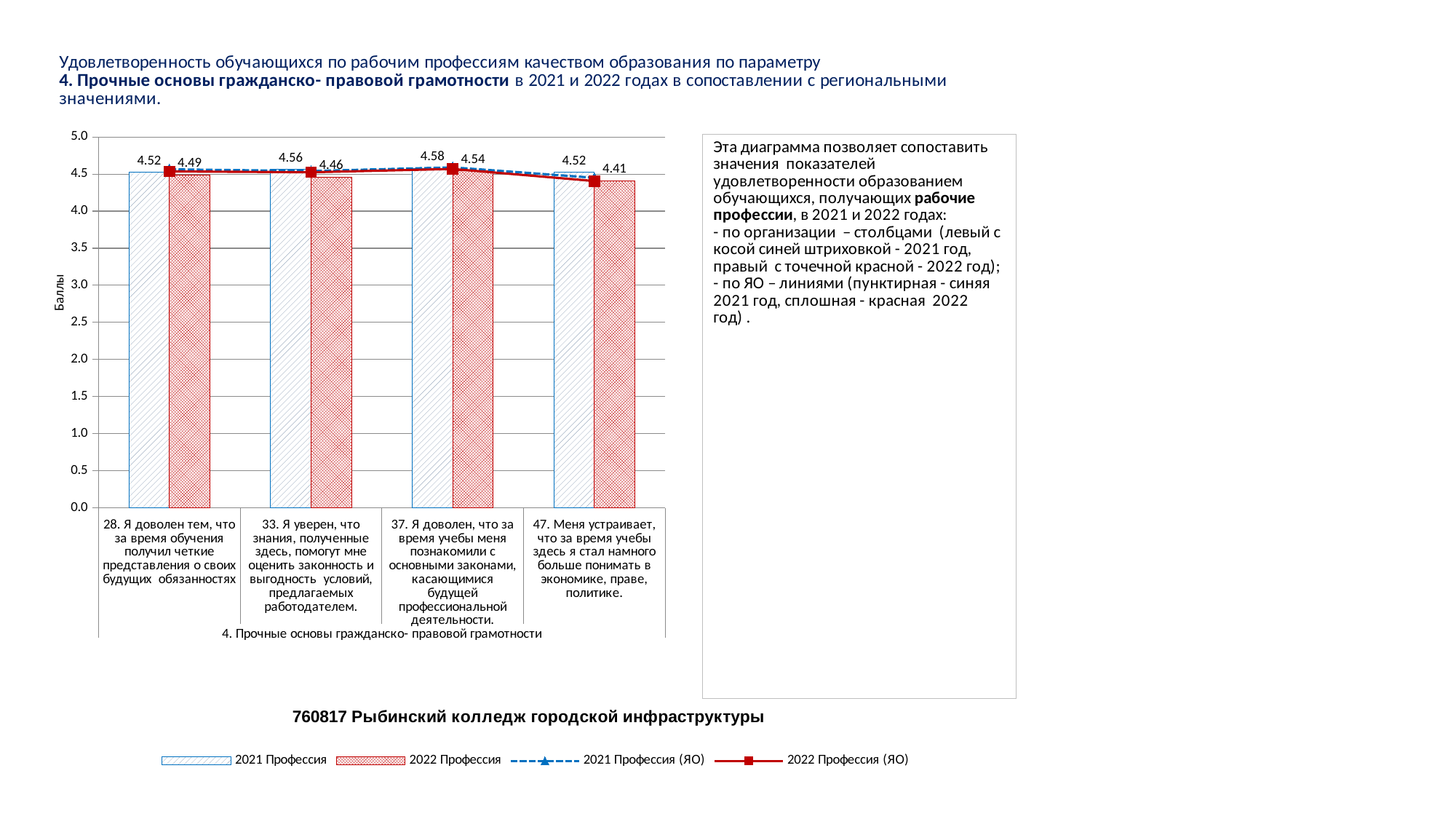
Is the 2022 Профессия value for item 37 greater or less than 4.0? greater Which item has the lowest 2022 Профессия value? 47. Меня устраивает, что за время учебы здесь я стал намного больше понимать в экономике, праве, политике. What is the difference between the 2021 Профессия and 2022 Профессия values for item 47? 0.11 Which item has the highest 2021 Профессия value? 37. Я доволен, что за время учебы меня познакомили с основными законами, касающимися будущей профессиональной деятельности. What is the 2022 Профессия value for item 33 (Я уверен, что знания, полученные здесь, помогут мне оценить законность и выгодность условий, предлагаемых работодателем)? 4.46 For item 33, which is larger: the 2021 Профессия value or the 2022 Профессия value? 2021 Профессия How many items (categories) are shown on the x axis of the chart? 4 What is the 2022 Профессия value for item 47 (Меня устраивает, что за время учебы здесь я стал намного больше понимать в экономике, праве, политике)? 4.41 What is the label of the vertical axis of the chart? Баллы How many series does the chart legend list? 4 What kind of chart is used to show the 2021 Профессия and 2022 Профессия values? Bar chart What is the 2021 Профессия value for item 28 (Я доволен тем, что за время обучения получил четкие представления о своих будущих обязанностях)? 4.52